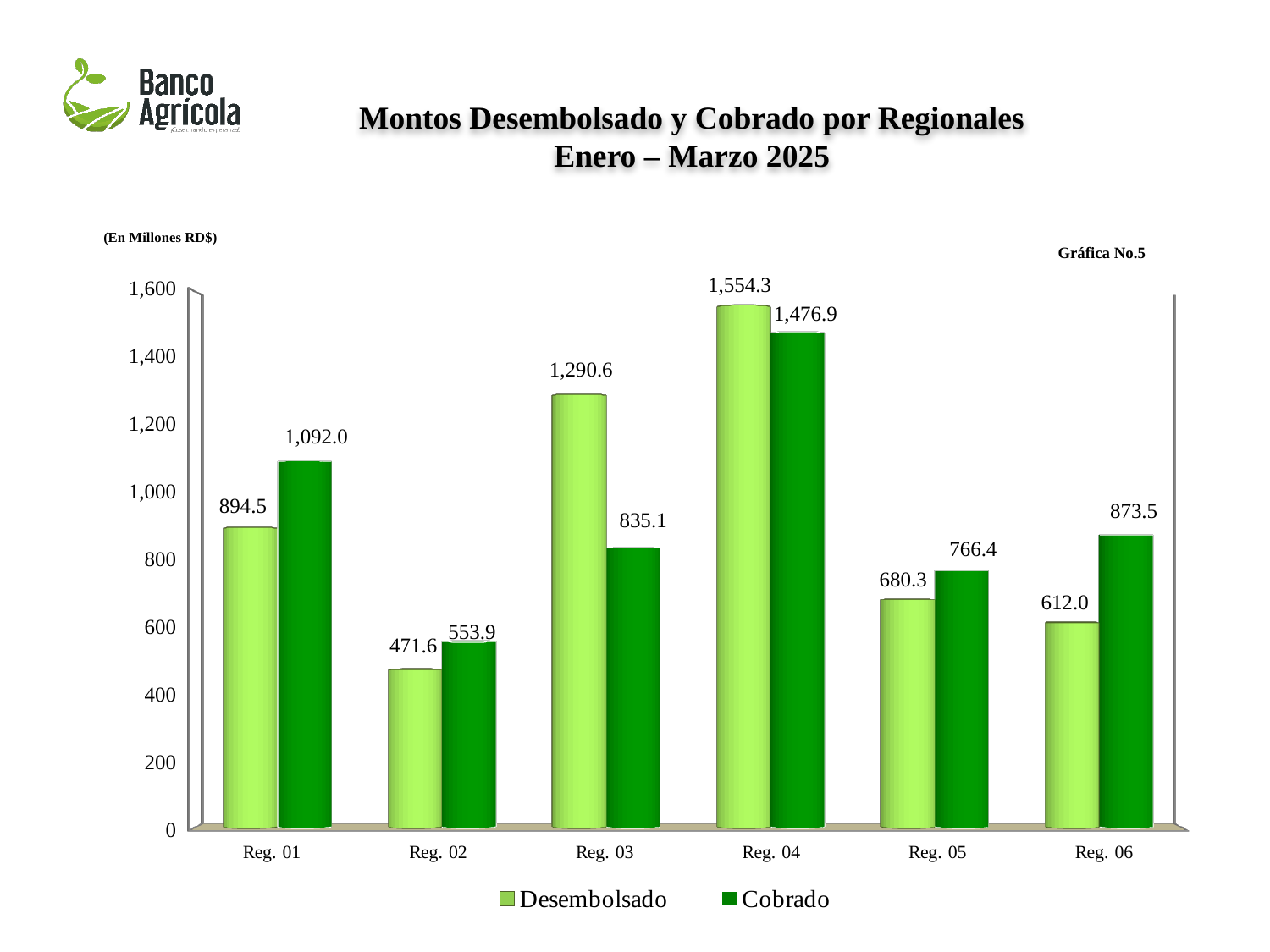
What kind of chart is shown on the slide? bar chart What is the difference between the Cobrado and Desembolsado values for Reg. 01? 197.5 Which region has the lowest Cobrado value? Reg. 02 What is the difference between the Desembolsado and Cobrado values for Reg. 03? 455.5 What is the Desembolsado value for Reg. 03? 1,290.6 What is the Cobrado value for Reg. 06? 873.5 Which region has the highest Desembolsado value? Reg. 04 How many series does the legend list? 2 Is the Cobrado value for Reg. 05 greater or less than 800? less For Reg. 04, which is larger, Desembolsado or Cobrado? Desembolsado What is the Desembolsado value for Reg. 05? 680.3 How many regions are shown on the x axis? 6